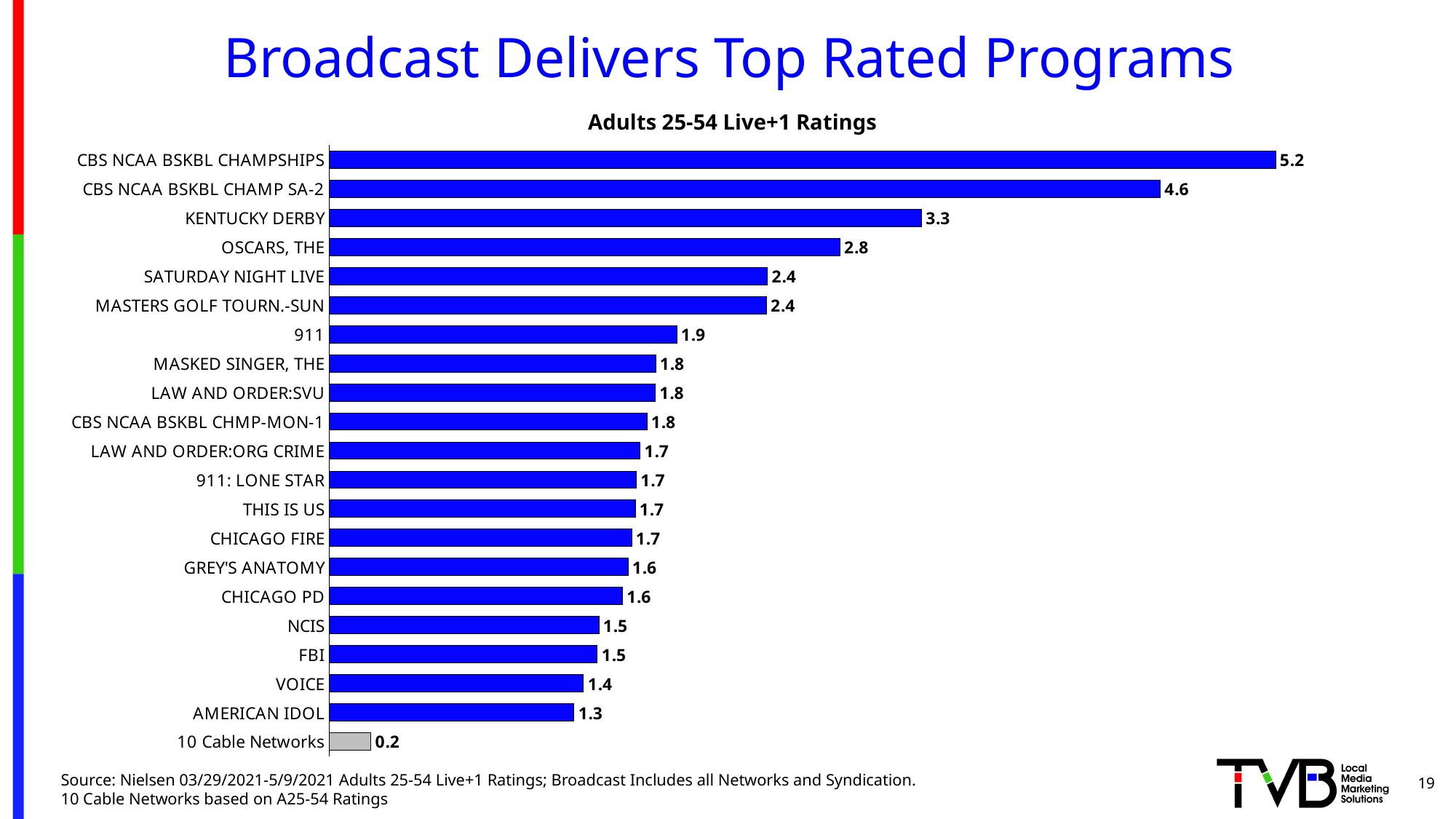
What is the rating shown for 10 Cable Networks? 0.2 What is the difference between the ratings for CBS NCAA BSKBL CHAMPSHIPS and CBS NCAA BSKBL CHAMP SA-2? 0.6 How many categories (bars) are shown on the chart? 21 Which category has the lowest value on the chart? 10 Cable Networks What is the rating for AMERICAN IDOL? 1.3 What is the title of the chart? Adults 25-54 Live+1 Ratings Which program has the highest rating on the chart? CBS NCAA BSKBL CHAMPSHIPS What is the rating for OSCARS, THE? 2.8 What type of chart is shown on the slide? Bar chart What is the Adults 25-54 Live+1 rating for KENTUCKY DERBY? 3.3 What is the difference between the rating for AMERICAN IDOL and the rating for 10 Cable Networks? 1.1 Which has a higher rating, 911 or VOICE? 911